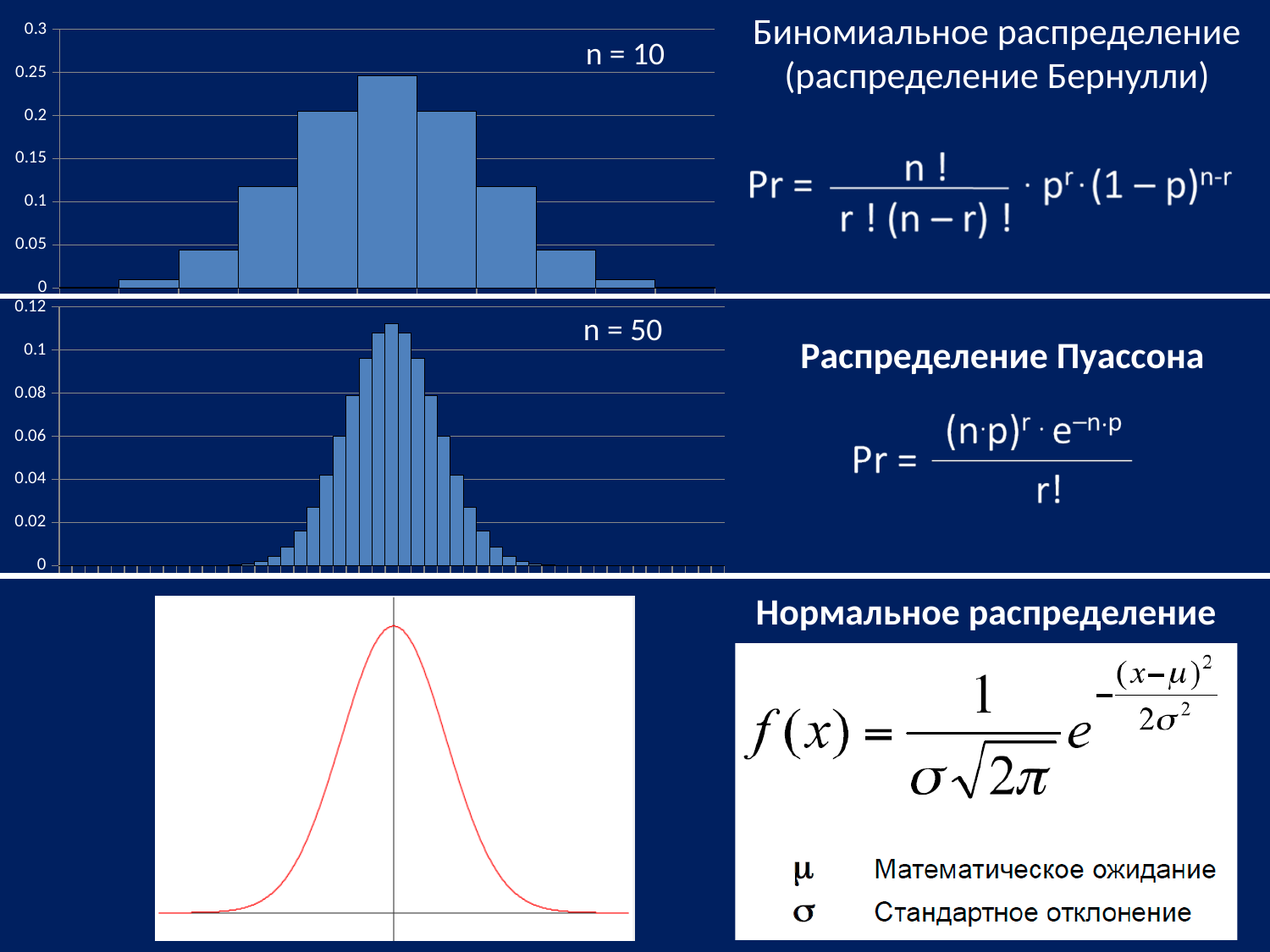
In the middle chart (n = 50), is the value of the tallest bar greater or less than 0.1? greater What colour is the curve in the bottom-left chart? red What kind of chart is the top chart labelled n = 10? bar chart In the top chart (n = 10), is the value of the tallest bar greater or less than 0.2? greater In the top chart (n = 10), do the bar values rise, fall, or rise then fall from left to right? rise then fall What label is printed in the upper right corner of the top chart? n = 10 What kind of chart is the bottom-left chart under 'Нормальное распределение'? line chart In the bottom-left chart, does the curve rise or fall from the centre peak towards the right edge? fall Which chart has the taller peak value, the one labelled n = 10 or the one labelled n = 50? n = 10 In the middle chart (n = 50), is the value of the tallest bar greater or less than 0.12? less